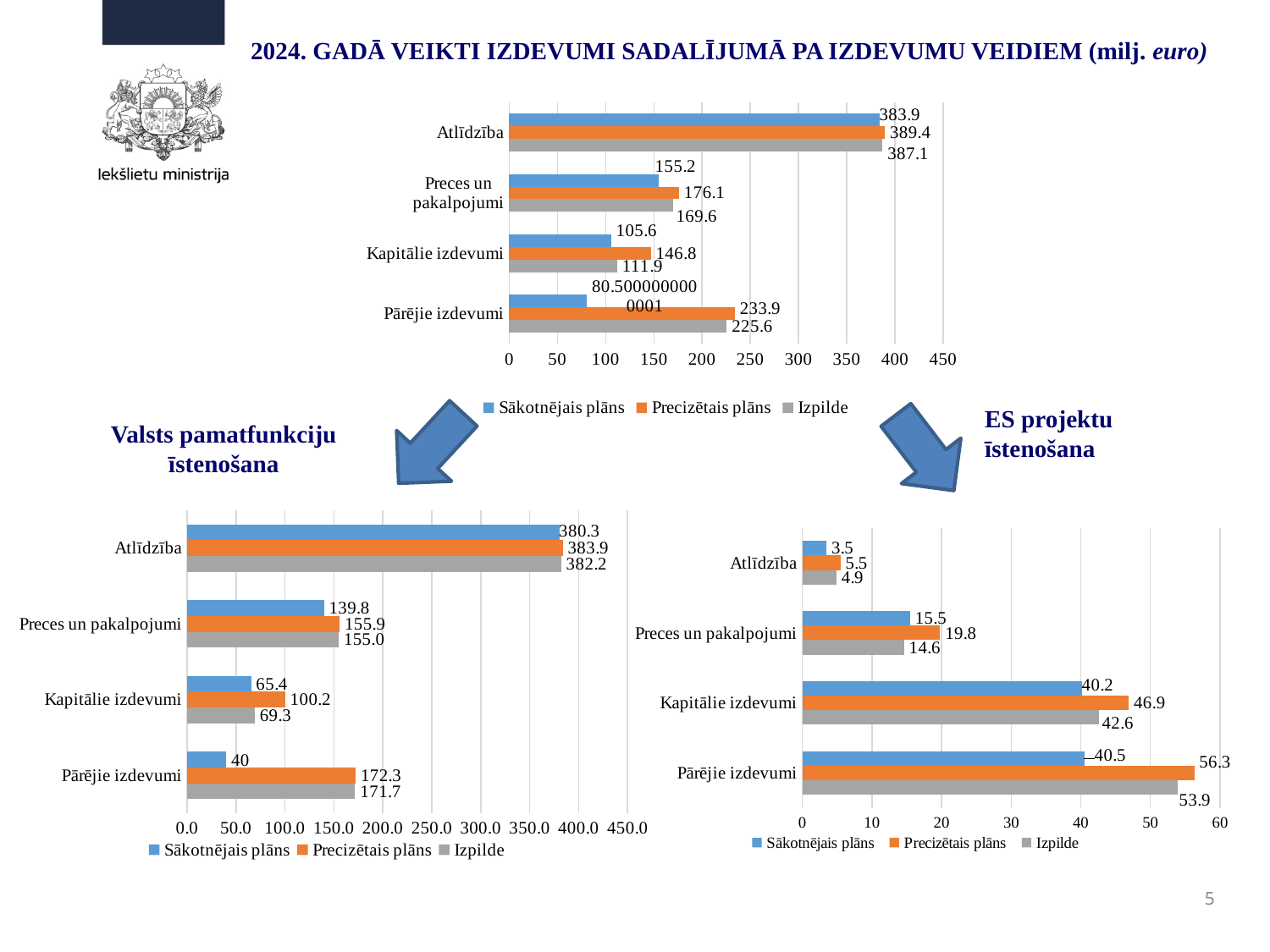
In the top chart, what is the Precizētais plāns value for Kapitālie izdevumi? 146.8 In the bottom-left chart (Valsts pamatfunkciju īstenošana), what is the Sākotnējais plāns value for Pārējie izdevumi? 40 What type of chart is the bottom-right chart (ES projektu īstenošana)? Bar chart In the bottom-left chart (Valsts pamatfunkciju īstenošana), is the Precizētais plāns value for Kapitālie izdevumi larger than the Izpilde value? Yes, Precizētais plāns (100.2) How many series does the legend of the top chart list? 3 In the top chart, what is the Izpilde value for Atlīdzība? 387.1 In the bottom-right chart (ES projektu īstenošana), what is the difference between the Precizētais plāns and Izpilde values for Kapitālie izdevumi? 4.3 In the bottom-right chart (ES projektu īstenošana), what is the Precizētais plāns value for Pārējie izdevumi? 56.3 In the bottom-left chart (Valsts pamatfunkciju īstenošana), which category has the lowest Izpilde value? Kapitālie izdevumi In the top chart, which category has the highest Izpilde value? Atlīdzība In the top chart, what is the difference between the Precizētais plāns and Izpilde values for Preces un pakalpojumi? 6.5 In the bottom-right chart (ES projektu īstenošana), which category has the lowest Sākotnējais plāns value? Atlīdzība